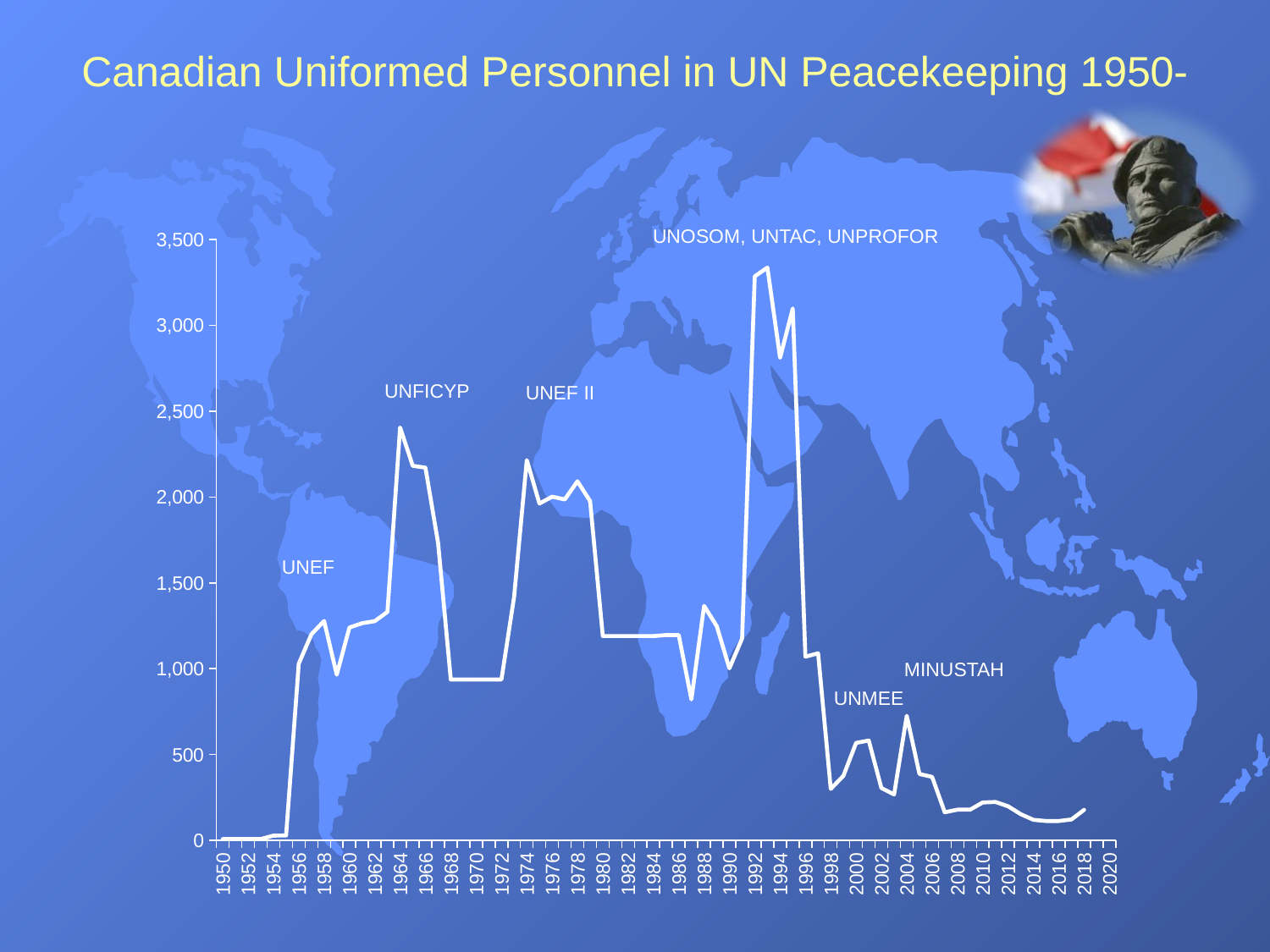
Is the value for 1987 greater or less than 1,000? less Which year has the larger value, 1992 or 2004? 1992 Is the value for 1992 greater or less than 3,000? greater Do the values rise or fall between 1954 and 1958? rise Is the value for 1964 greater or less than 2,000? greater Which mission label is placed near the peak around 1964? UNFICYP What is the title of the chart? Canadian Uniformed Personnel in UN Peacekeeping 1950- Do the values rise or fall between 1996 and 2000? fall Which annotated mission period corresponds to the highest peak on the chart? UNOSOM, UNTAC, UNPROFOR What kind of chart is shown on the slide? line chart